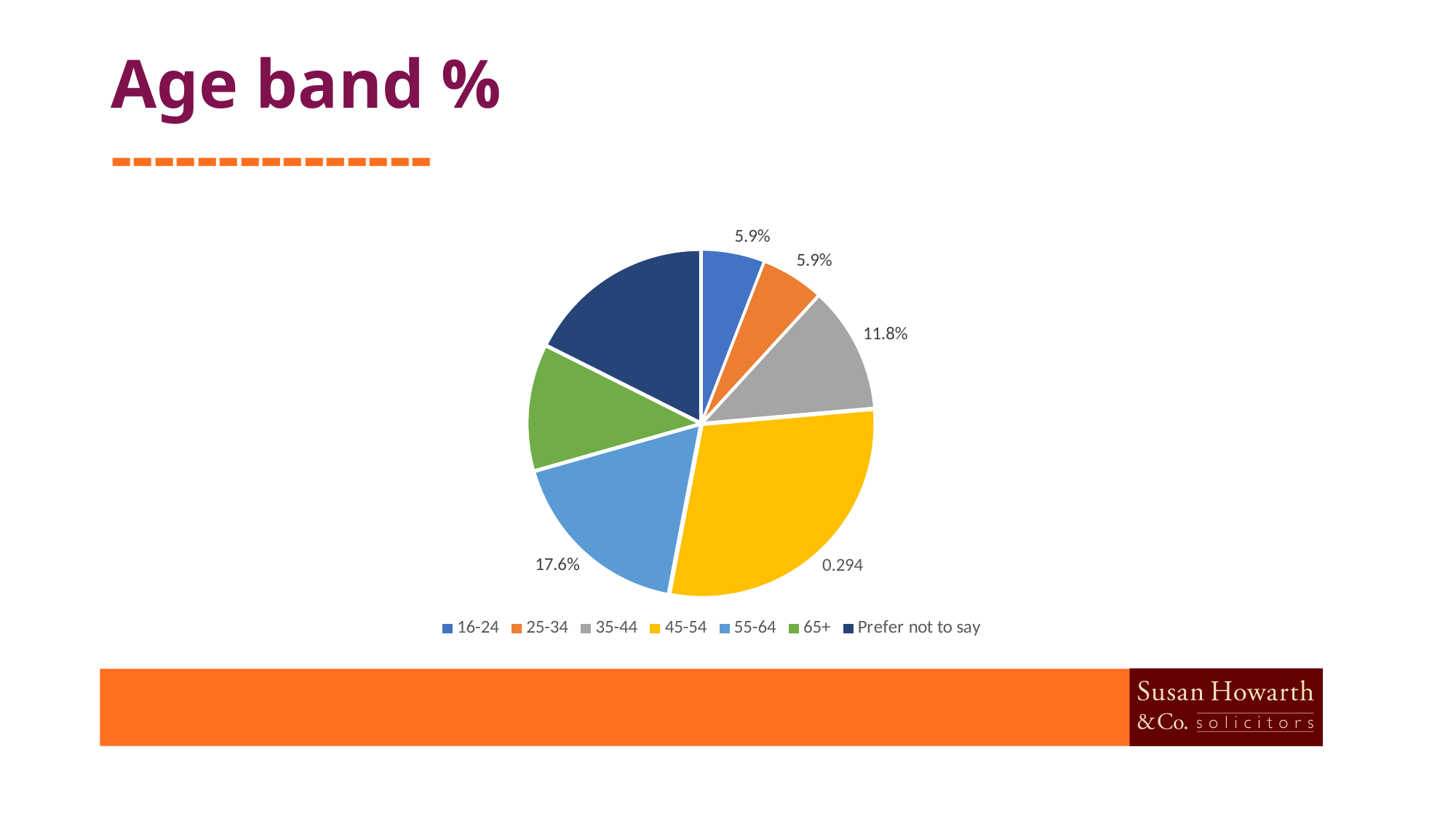
How many categories does the legend list? 7 What is the difference between the 35-44 value and the 25-34 value? 5.9% What is the title of the slide? Age band % Which age band has the largest slice of the pie? 45-54 Which is larger, the 55-64 slice or the 35-44 slice? 55-64 What kind of chart is shown on the slide? Pie chart What is the value shown for the 55-64 slice? 17.6% What is the value shown for the 16-24 slice? 5.9% What label is printed on the 45-54 slice? 0.294 What is the value shown for the 35-44 slice? 11.8% What is the difference between the 55-64 value and the 35-44 value? 5.8% Which is larger, the 65+ slice or the Prefer not to say slice? Prefer not to say